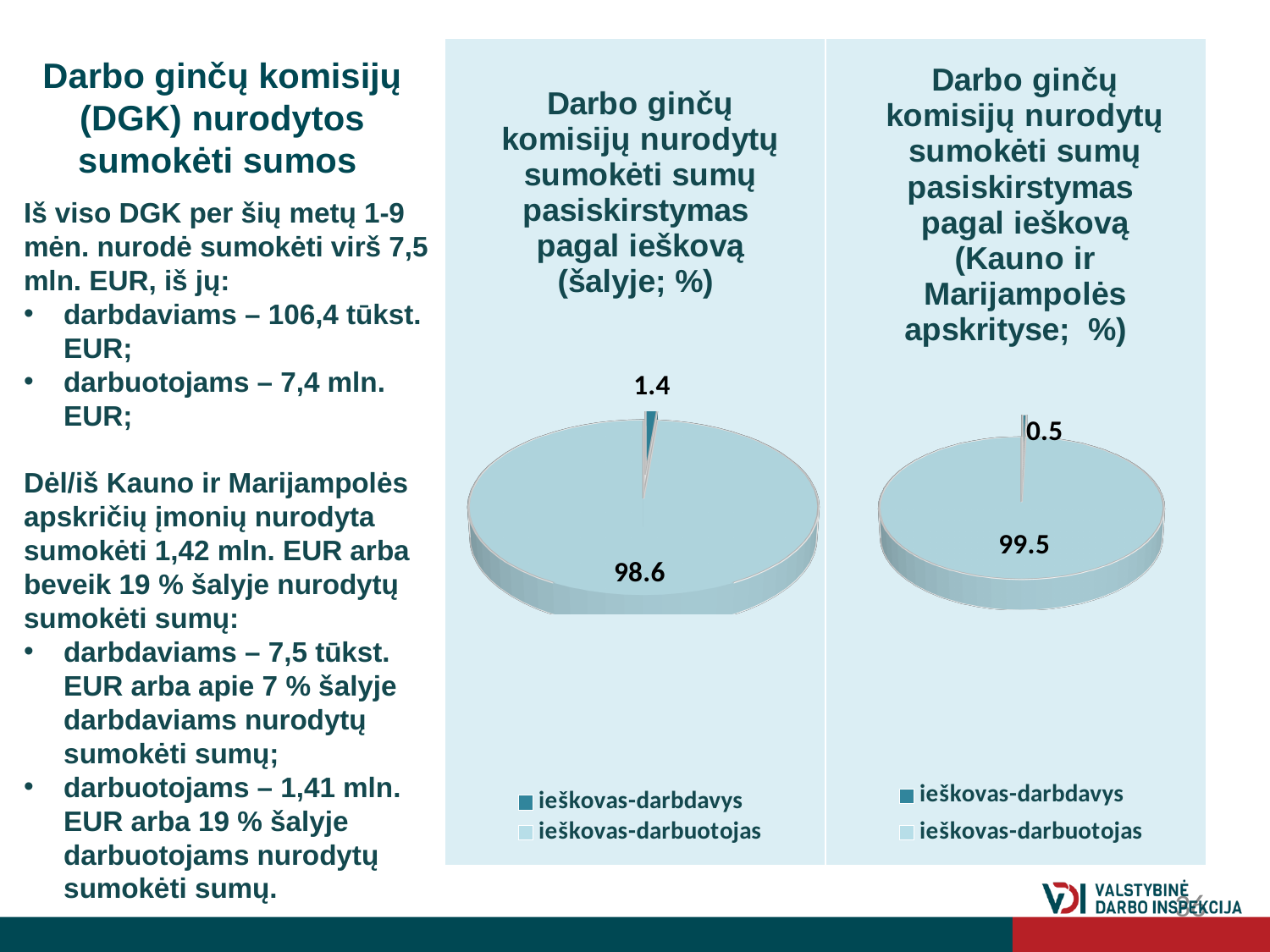
In the left chart (šalyje; %), what is the value for ieškovas-darbdavys? 1.4 Which is larger: the ieškovas-darbdavys value in the left chart or in the right chart? left chart In the right chart (Kauno ir Marijampolės apskrityse; %), what is the difference between the ieškovas-darbuotojas and ieškovas-darbdavys values? 99.0 In the left chart (šalyje; %), which category has the largest slice? ieškovas-darbuotojas How many slices does the left chart (šalyje; %) have? 2 In the right chart (Kauno ir Marijampolės apskrityse; %), which category has the smallest slice? ieškovas-darbdavys In the left chart (šalyje; %), what is the value for ieškovas-darbuotojas? 98.6 How many series does the legend of the right chart (Kauno ir Marijampolės apskrityse; %) list? 2 In the right chart (Kauno ir Marijampolės apskrityse; %), what is the value for ieškovas-darbuotojas? 99.5 In the right chart (Kauno ir Marijampolės apskrityse; %), what is the value for ieškovas-darbdavys? 0.5 In the left chart (šalyje; %), what is the difference between the ieškovas-darbuotojas and ieškovas-darbdavys values? 97.2 What type of chart is the left chart (šalyje; %)? pie chart